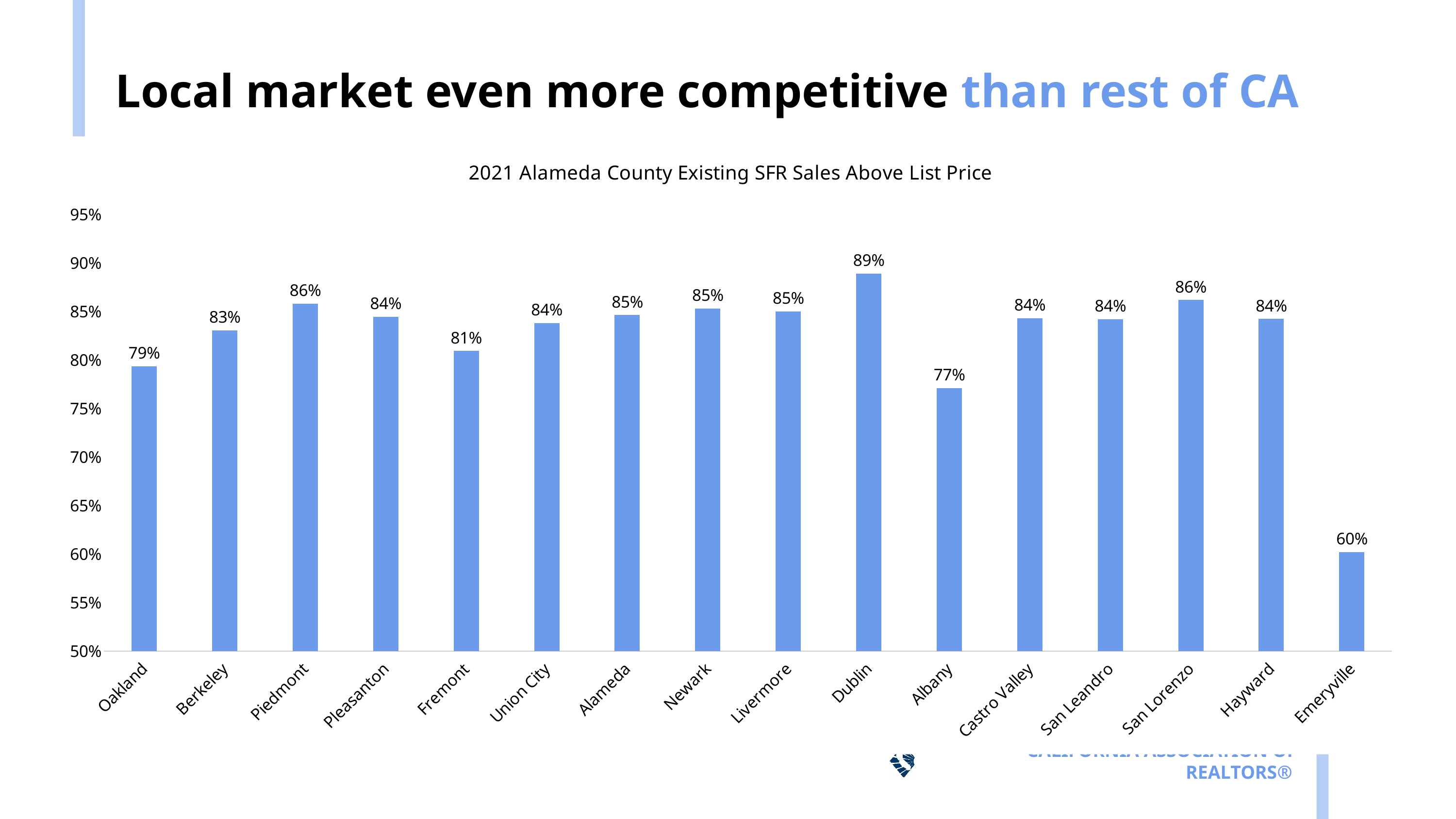
Which is larger, the value for Berkeley or the value for Albany? Berkeley Which city has the lowest share of sales above list price? Emeryville Which city has the highest share of sales above list price? Dublin What is the value for Albany? 77% What is the value for Oakland? 79% How many cities are shown on the chart? 16 What is the value for Dublin? 89% What is the title of the chart? 2021 Alameda County Existing SFR Sales Above List Price What is the value for Emeryville? 60% What is the difference between the values for Piedmont and Fremont? 5% What is the difference between the values for Dublin and Emeryville? 29% What kind of chart is shown on the slide? Bar chart